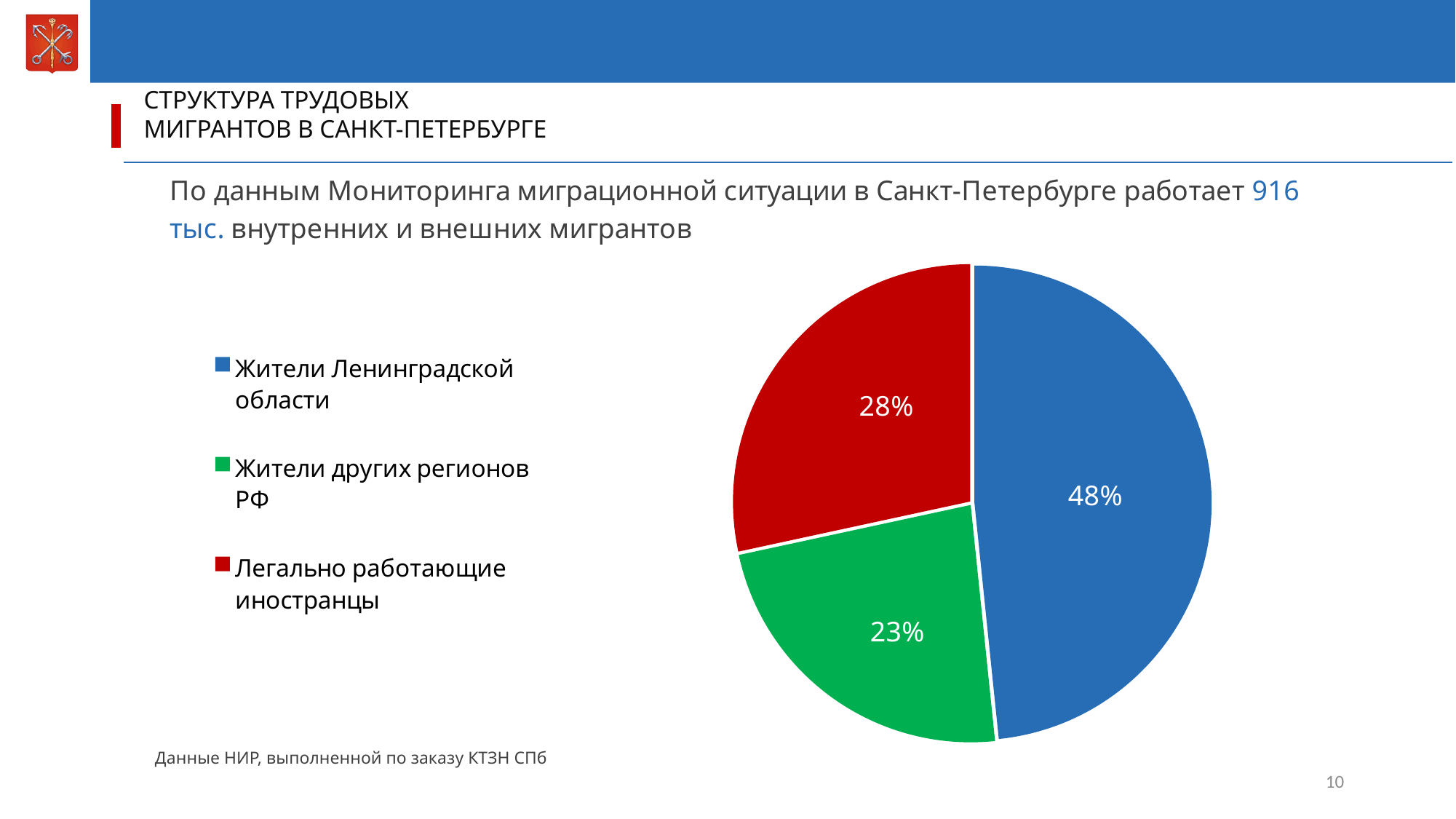
Which category has the smallest slice of the pie? Жители других регионов РФ Which slice is larger: Легально работающие иностранцы or Жители других регионов РФ? Легально работающие иностранцы What kind of chart is shown on the slide? Pie chart What is the difference in percentage points between the slice for Жители Ленинградской области and the slice for Легально работающие иностранцы? 20 What colour is the slice for Легально работающие иностранцы? Red What share of the pie is labelled for Жители Ленинградской области? 48% What share of the pie is labelled for Легально работающие иностранцы? 28% What is the difference in percentage points between the slice for Легально работающие иностранцы and the slice for Жители других регионов РФ? 5 What colour is the slice for Жители других регионов РФ? Green How many slices does the pie chart have? 3 Which category has the largest slice of the pie? Жители Ленинградской области What share of the pie is labelled for Жители других регионов РФ? 23%